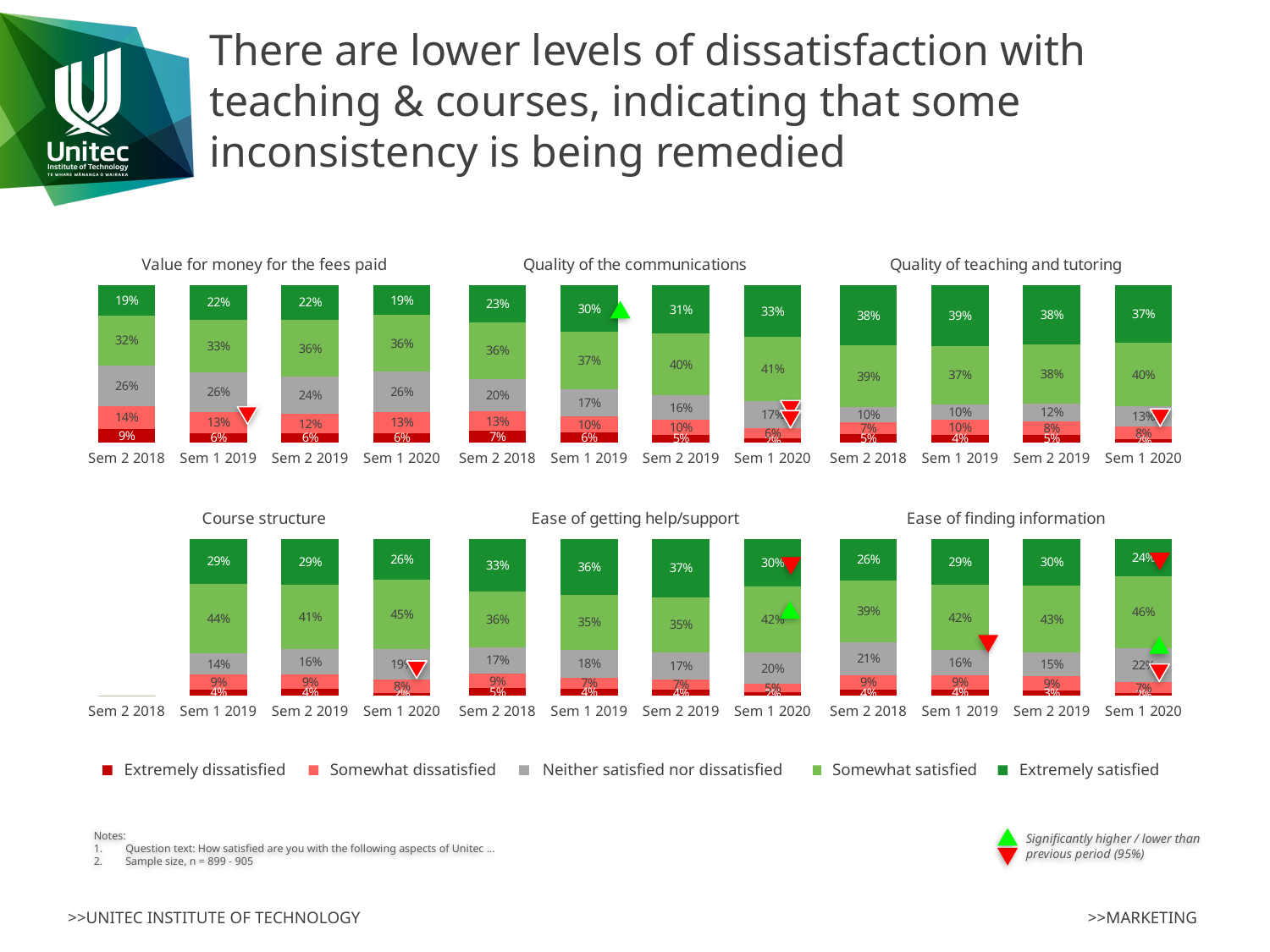
How many series does the legend list? 5 In the 'Value for money for the fees paid' chart, what percentage were somewhat satisfied in Sem 2 2019? 36% In the 'Quality of the communications' chart, which semester has the highest extremely satisfied percentage? Sem 1 2020 In the 'Quality of teaching and tutoring' chart, what percentage were somewhat satisfied in Sem 1 2020? 40% In the 'Ease of finding information' chart, what percentage were neither satisfied nor dissatisfied in Sem 2 2018? 21% In the 'Ease of getting help/support' chart, which semester has the lowest extremely satisfied percentage? Sem 1 2020 In the 'Course structure' chart, what percentage were somewhat satisfied in Sem 1 2020? 45% In the 'Quality of teaching and tutoring' chart, what is the difference between the somewhat satisfied percentages for Sem 1 2020 and Sem 1 2019? 3% What kind of chart is used for 'Quality of teaching and tutoring'? Stacked bar chart In the 'Ease of finding information' chart, is the somewhat satisfied percentage larger in Sem 1 2020 or Sem 2 2018? Sem 1 2020 In the 'Quality of the communications' chart, what percentage were extremely satisfied in Sem 1 2020? 33% In the 'Value for money for the fees paid' chart, what percentage were extremely satisfied in Sem 2 2018? 19%